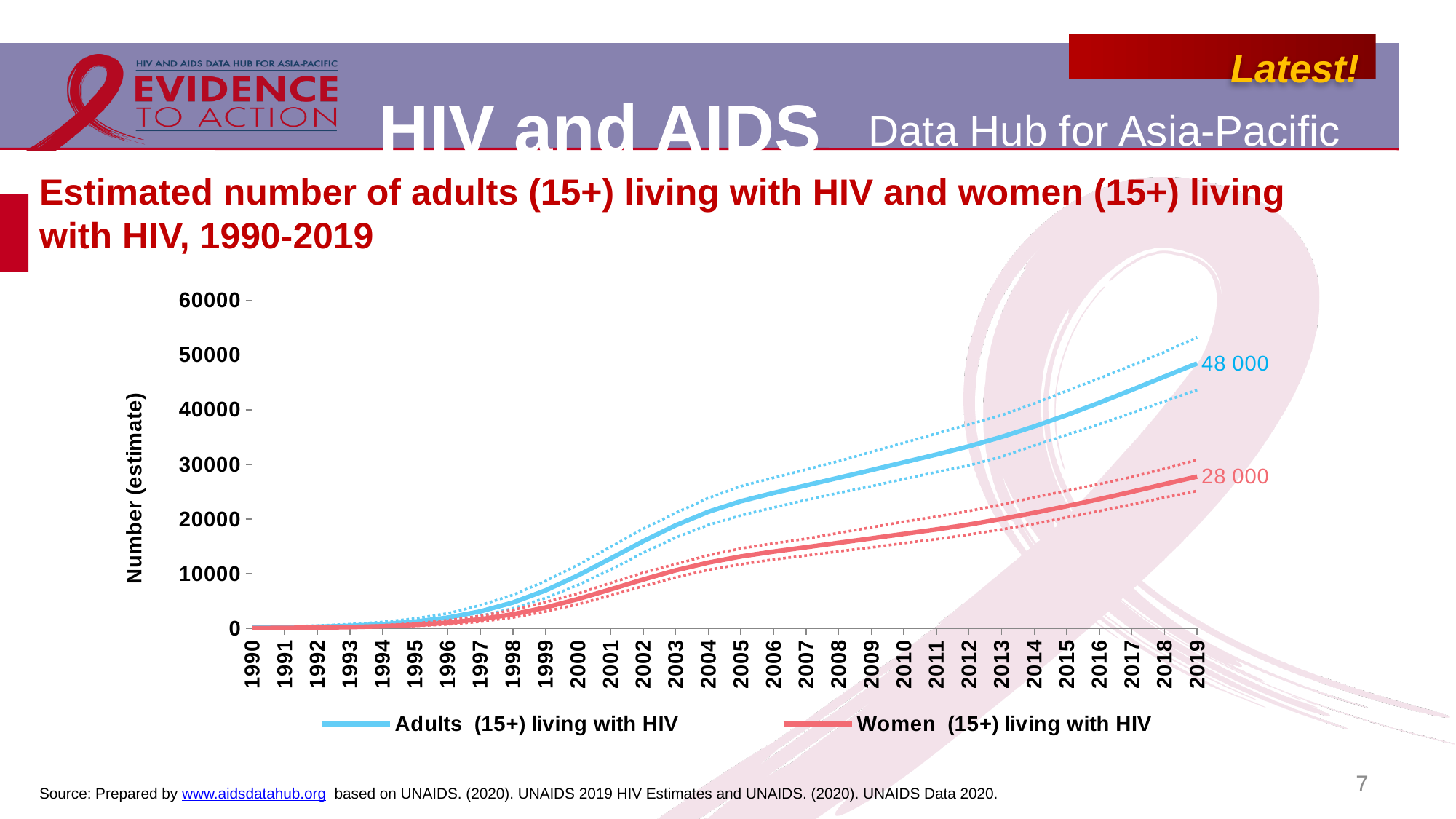
What is the estimated number of women (15+) living with HIV in 2019? 28 000 How many series does the legend list? 2 What is the estimated number of adults (15+) living with HIV in 2019? 48 000 What is the difference between the 2019 values for adults (15+) living with HIV and women (15+) living with HIV? 20 000 Is the value for Women (15+) living with HIV in 2005 greater or less than 20000? less Is the value for Adults (15+) living with HIV in 2010 greater or less than 20000? greater How many years are shown on the x axis of the chart? 30 Do the values for Adults (15+) living with HIV rise or fall from 1990 to 2019? rise What kind of chart is shown on the slide? line chart In 2019, which series has the larger value: Adults (15+) living with HIV or Women (15+) living with HIV? Adults (15+) living with HIV Is the value for Adults (15+) living with HIV in 2017 greater or less than 40000? greater What is the title of the y axis? Number (estimate)